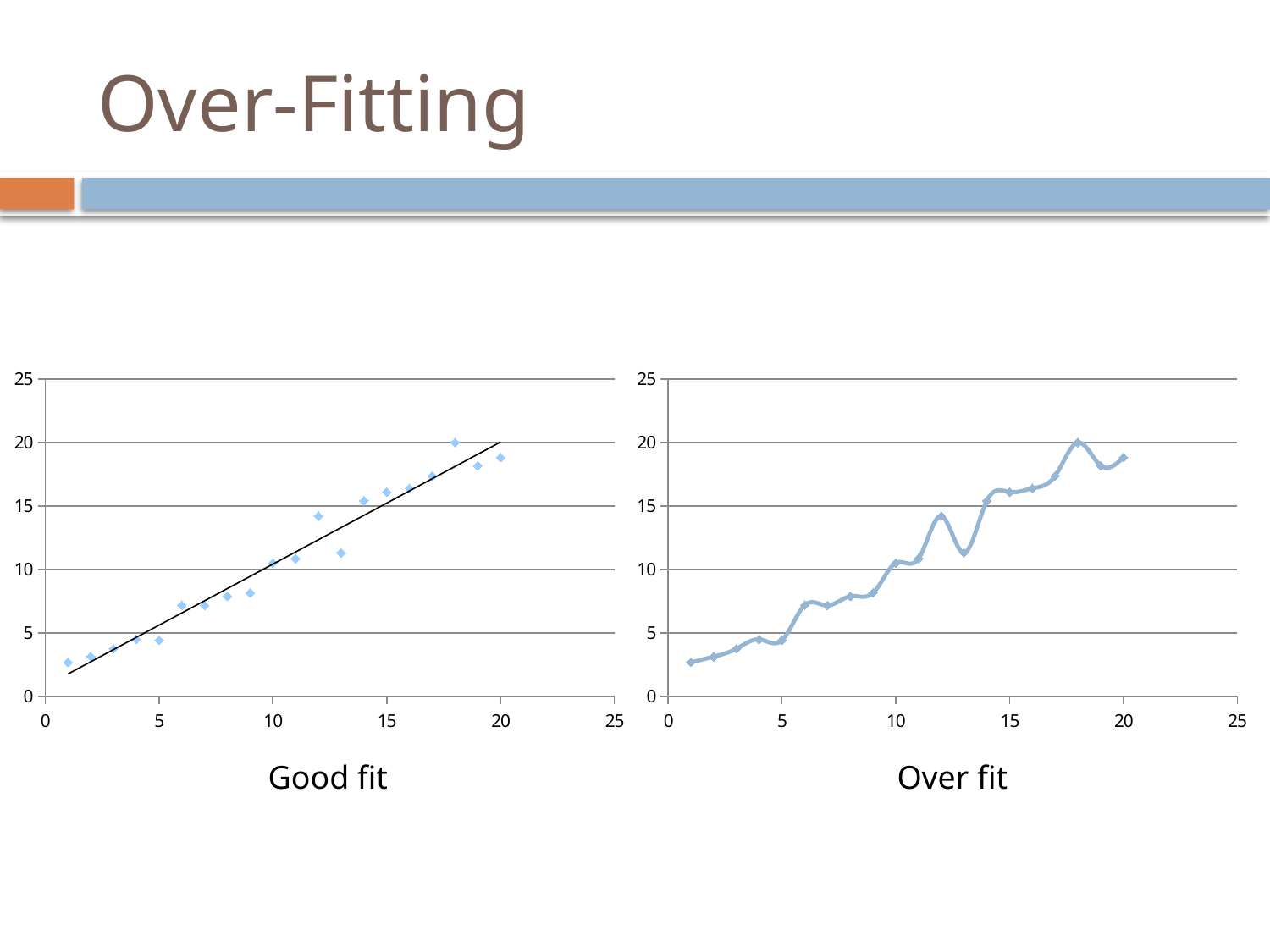
In the 'Good fit' chart, is the value at x = 20 greater or less than 20? less In the 'Good fit' chart, which has the larger value: the point at x = 18 or the point at x = 19? x = 18 In the 'Over fit' chart, which has the larger value: the point at x = 12 or the point at x = 13? x = 12 In the 'Good fit' chart, at which x value does the lowest point occur? 1 In the 'Over fit' chart, is the value at x = 1 greater or less than 5? less In the 'Over fit' chart on the right, do the values generally rise or fall as x increases from 0 to 20? rise What caption appears below the chart on the right? Over fit In the 'Over fit' chart, at which x value does the highest point occur? 18 What is the maximum value shown on the y axis of the 'Good fit' chart? 25 In the 'Over fit' chart, is the value at x = 12 greater or less than 10? greater What kind of chart is the 'Good fit' chart on the left? scatter chart How many data points are plotted in the 'Good fit' chart? 20